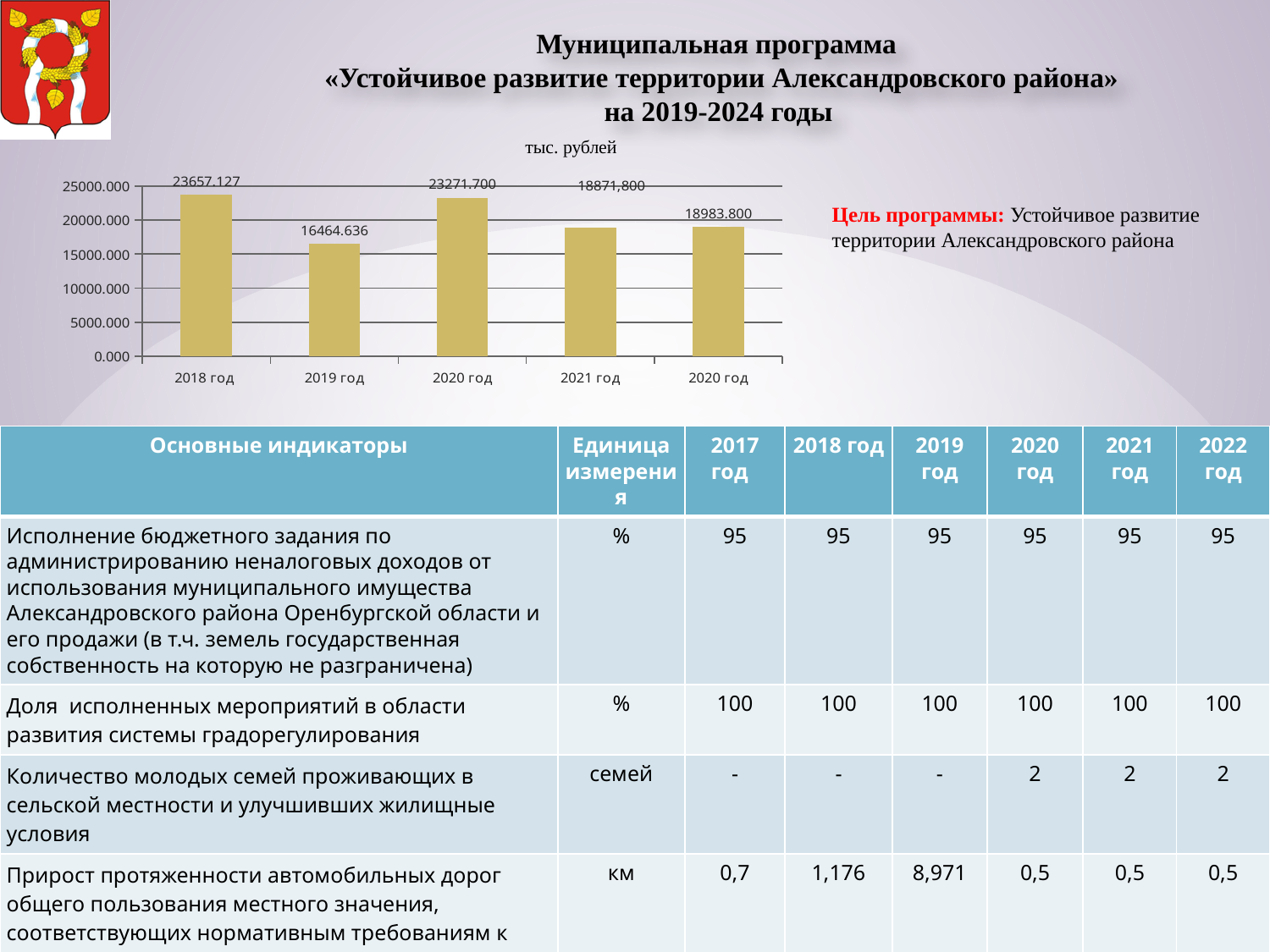
What is the value for 2019 год in the bar chart? 16464.636 What type of chart is shown on the slide? bar chart Which bar has the highest value in the bar chart? 2018 год What is the value of the third bar from the left (labelled 2020 год) in the bar chart? 23271.700 How many bars are shown in the bar chart? 5 What unit is indicated above the bar chart? тыс. рублей Is the value for 2019 год in the bar chart greater or less than 20000.000? less What is the difference between the values for 2018 год and 2019 год in the bar chart? 7192.491 What is the value for 2018 год in the bar chart? 23657.127 Which year has the lowest value in the bar chart? 2019 год What is the value for 2021 год in the bar chart? 18871,800 Which is larger in the bar chart: the value for 2019 год or the value for 2021 год? 2021 год